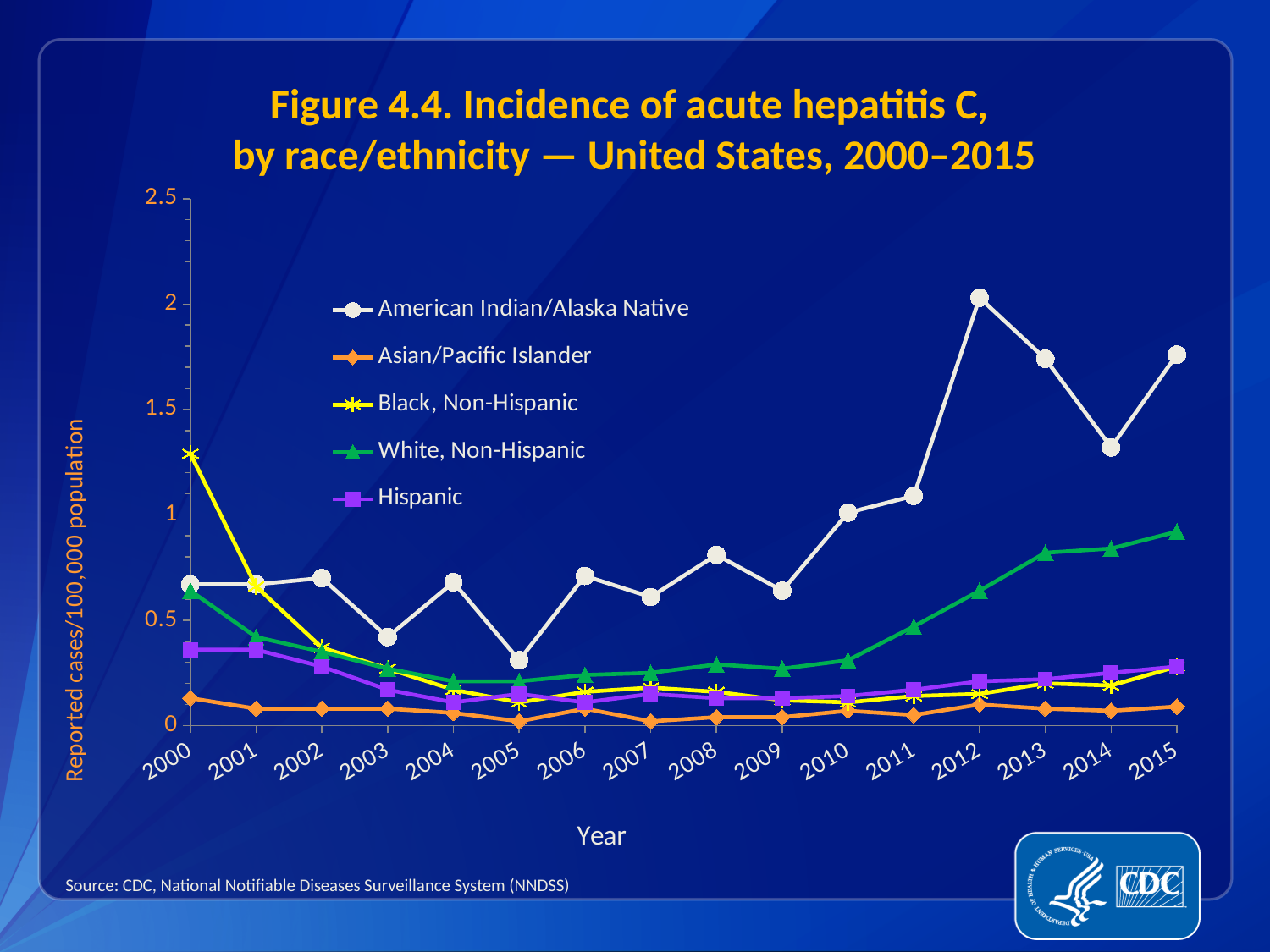
Is the value for Black, Non-Hispanic in 2000 greater or less than 1? greater Does the White, Non-Hispanic series rise or fall from 2010 to 2015? Rise How many series does the legend list? 5 Is the value for White, Non-Hispanic in 2015 greater or less than 1? less What kind of chart is shown on the slide? Line chart How many years are plotted along the x axis? 16 Is the value for American Indian/Alaska Native in 2012 greater or less than 1.5? greater Which race/ethnicity group has the lowest incidence in 2015? Asian/Pacific Islander In which year does the American Indian/Alaska Native series reach its highest value? 2012 What is the label of the y axis? Reported cases/100,000 population Which race/ethnicity group has the highest incidence in 2000? Black, Non-Hispanic Which race/ethnicity group has the highest incidence in 2015? American Indian/Alaska Native